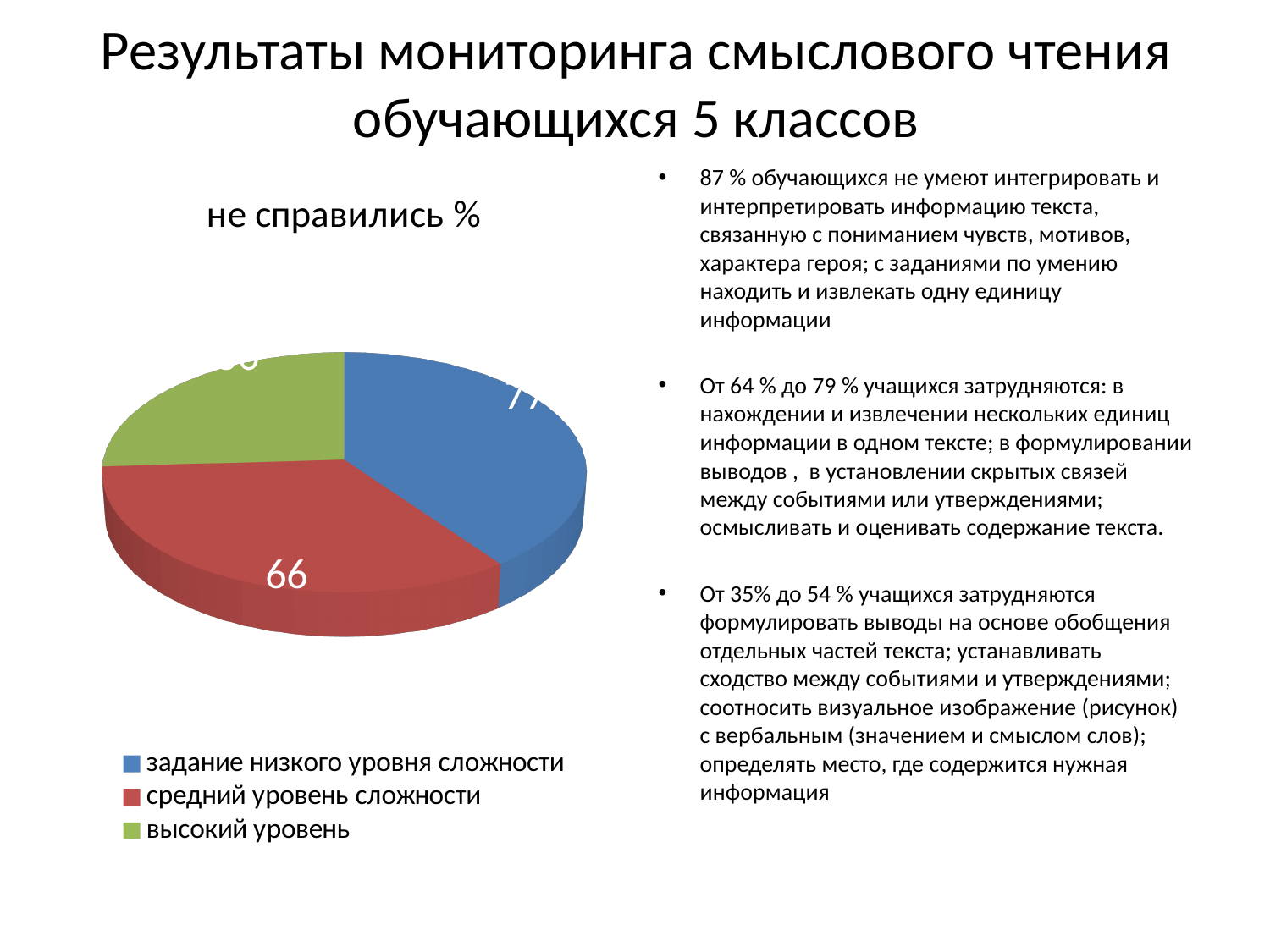
Which slice is larger: 'средний уровень сложности' or 'высокий уровень'? средний уровень сложности Which slice is larger: 'задание низкого уровня сложности' or 'высокий уровень'? задание низкого уровня сложности What value is shown for 'средний уровень сложности'? 66 What kind of chart is shown on the slide? pie chart What is the title of the chart? не справились % How many entries does the chart legend list? 3 Which category has the smallest slice of the pie? высокий уровень What colour is the slice for 'средний уровень сложности'? red How many slices does the pie chart have? 3